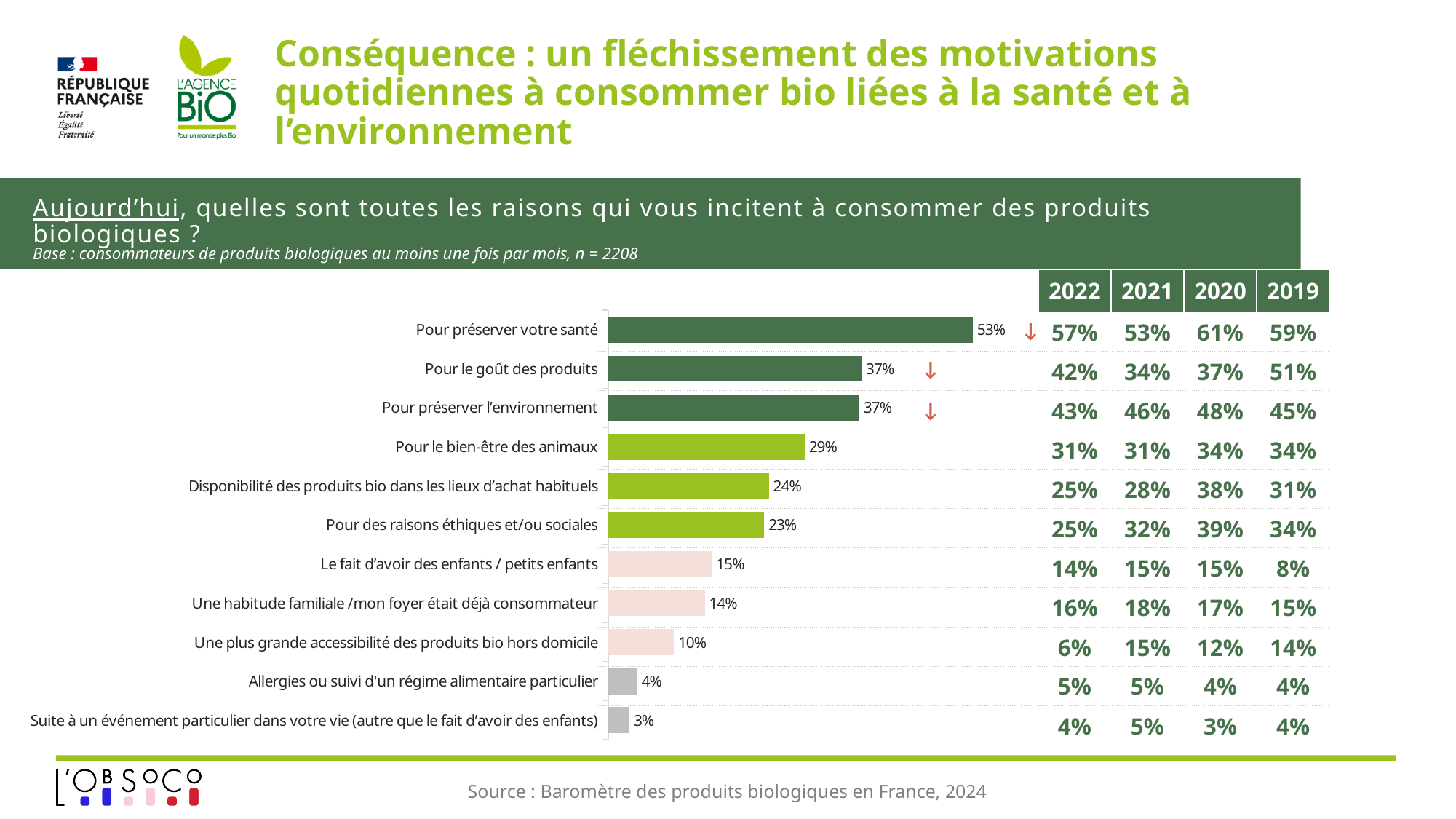
Which is larger: the value for "Disponibilité des produits bio dans les lieux d'achat habituels" or for "Le fait d'avoir des enfants / petits enfants"? Disponibilité des produits bio dans les lieux d'achat habituels What is the sample size (n) stated in the base line under the question? 2208 What is the value for "Une plus grande accessibilité des produits bio hors domicile"? 10% Which category has the highest value? Pour préserver votre santé What is the value for "Pour préserver votre santé"? 53% What is the difference between the values for "Pour le bien-être des animaux" and "Pour des raisons éthiques et/ou sociales"? 6% How many categories are shown in the bar chart? 11 Which category has the lowest value? Suite à un événement particulier dans votre vie (autre que le fait d'avoir des enfants) What is the value for "Allergies ou suivi d'un régime alimentaire particulier"? 4% What is the value for "Pour le bien-être des animaux"? 29% What kind of chart is shown on the slide? Bar chart What is the difference between the values for "Pour préserver votre santé" and "Pour le goût des produits"? 16%